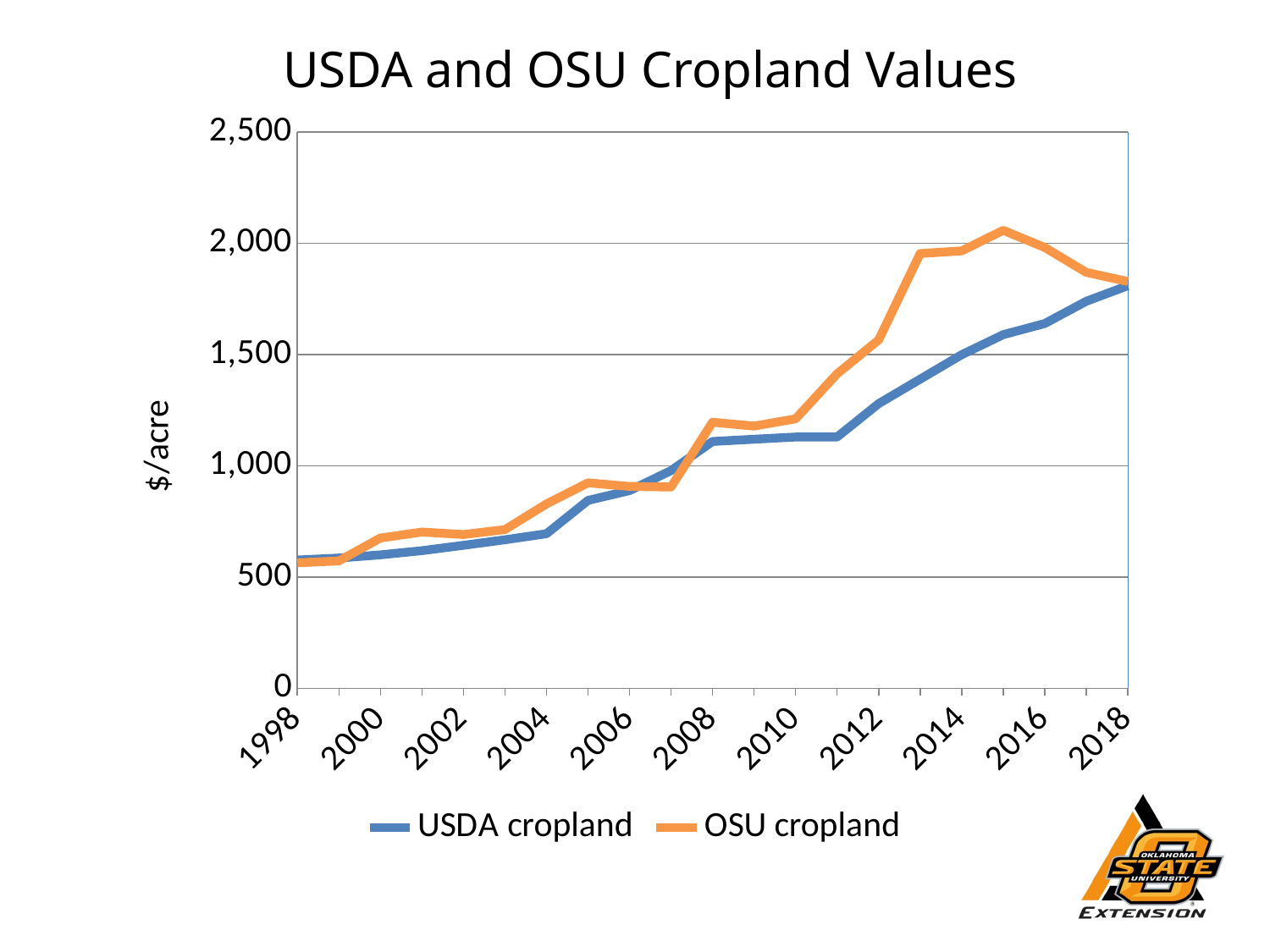
What is the label on the vertical axis? $/acre In which year does OSU cropland reach its highest value? 2015 In 2014, which series has the larger value, USDA cropland or OSU cropland? OSU cropland Is the value for OSU cropland in 2006 greater or less than 1,000? less Does the USDA cropland series generally rise or fall from 1998 to 2018? rise What kind of chart is shown on the slide? line chart What is the title of the chart? USDA and OSU Cropland Values In which year is USDA cropland at its lowest value? 1998 How many series does the legend list? 2 Is the value for OSU cropland in 2015 greater or less than 2,000? greater Is the value for USDA cropland in 2018 greater or less than 1,500? greater